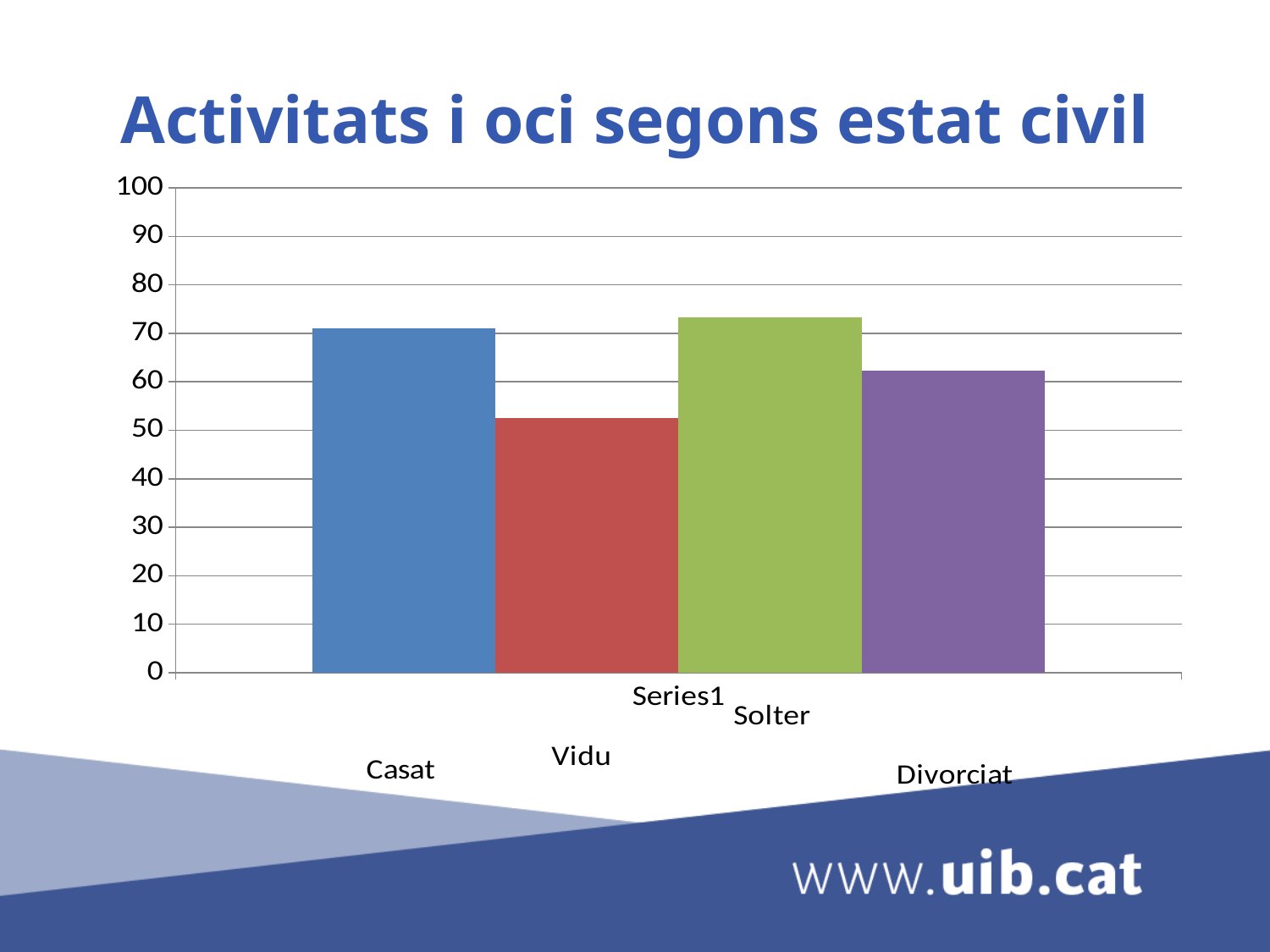
What is the title of the slide's chart? Activitats i oci segons estat civil Which is larger, the value for Casat or the value for Vidu? Casat What kind of chart is shown on the slide? bar chart Which is larger, the value for Divorciat or the value for Vidu? Divorciat What colour is the bar for Solter? green Is the value for Casat greater or less than 60? greater How many bars (categories) are plotted in the chart? 4 Which is larger, the value for Solter or the value for Divorciat? Solter Is the value for Vidu greater or less than 60? less Is the value for Solter greater or less than 80? less Which category has the lowest bar in the chart? Vidu